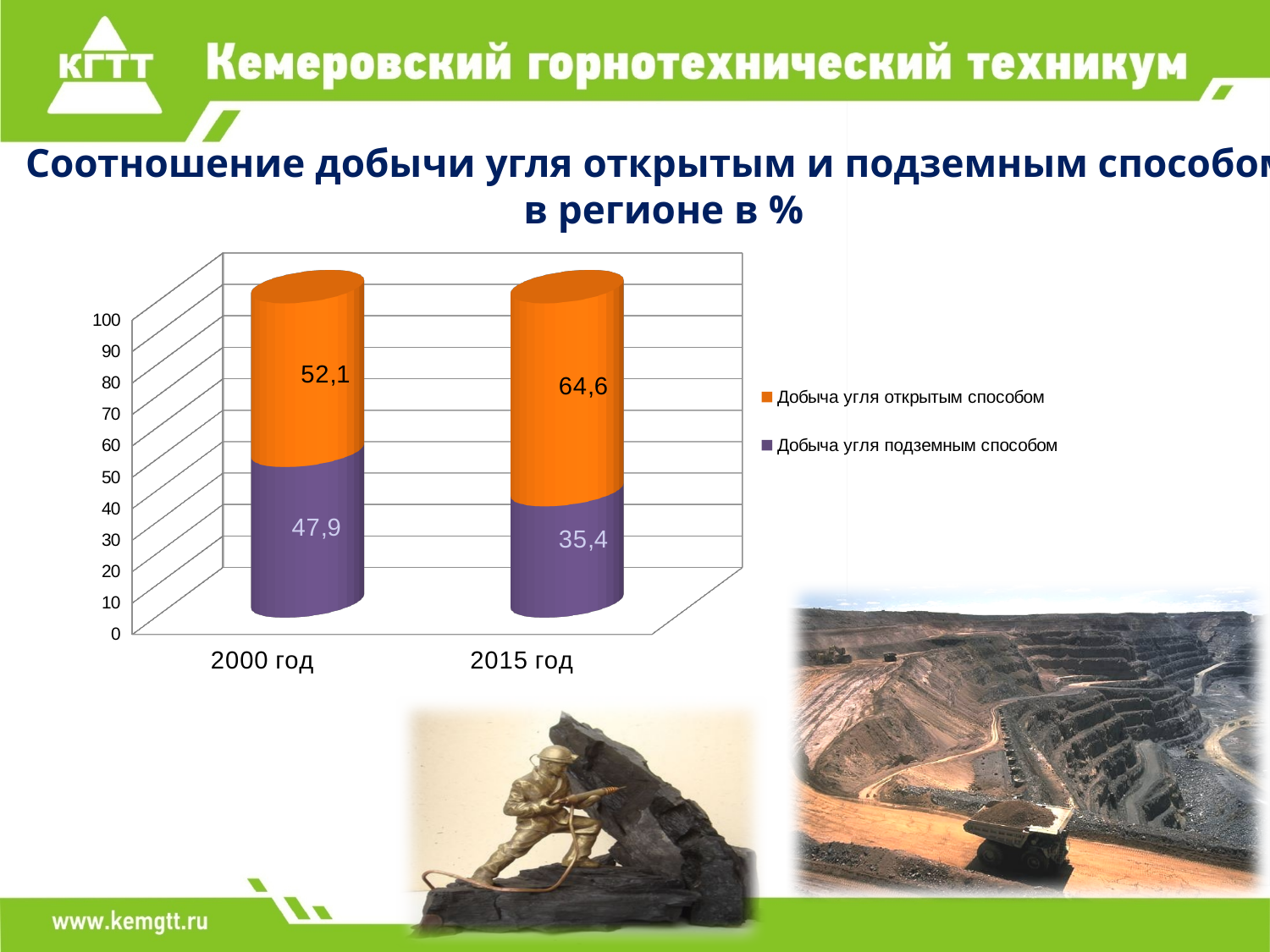
In which year is the value for 'Добыча угля открытым способом' highest? 2015 год How many series does the legend list? 2 In which year is the value for 'Добыча угля подземным способом' lowest? 2015 год What is the value for 'Добыча угля подземным способом' in 2015 год? 35,4 What kind of chart is shown on the slide? Stacked bar chart What is the value for 'Добыча угля открытым способом' in 2015 год? 64,6 What is the value for 'Добыча угля подземным способом' in 2000 год? 47,9 How many categories (years) are shown on the x axis? 2 What is the total of the stacked bar for 2015 год? 100 Which is larger in 2000 год: 'Добыча угля открытым способом' or 'Добыча угля подземным способом'? Добыча угля открытым способом What is the value for 'Добыча угля открытым способом' in 2000 год? 52,1 What is the difference between the 'Добыча угля открытым способом' values for 2015 год and 2000 год? 12,5